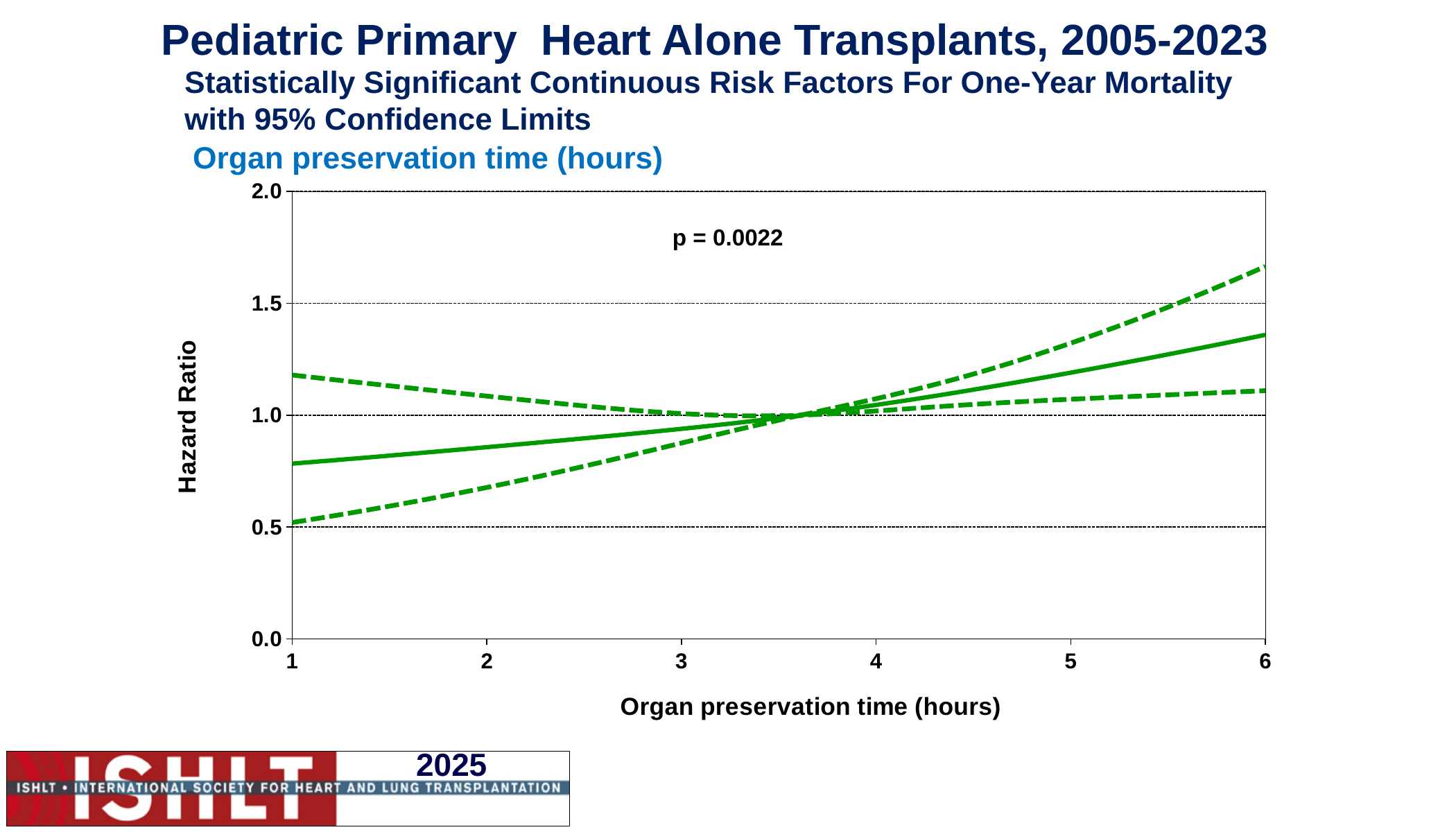
What is the p-value printed on the chart? p = 0.0022 How many tick labels are shown on the x axis? 6 What is the highest value labelled on the y axis? 2.0 What kind of chart is shown on the slide? line chart What is the label of the y axis? Hazard Ratio Is the lower dashed confidence limit at 3 hours of organ preservation time greater or less than 1.0? less Is the hazard ratio on the solid line at 1 hour of organ preservation time greater or less than 1.0? less Is the upper dashed confidence limit at 6 hours of organ preservation time greater or less than 1.5? greater Is the solid hazard ratio line higher at 6 hours or at 1 hour of organ preservation time? 6 hours Does the solid hazard ratio line rise or fall as organ preservation time increases from 1 to 6 hours? rise